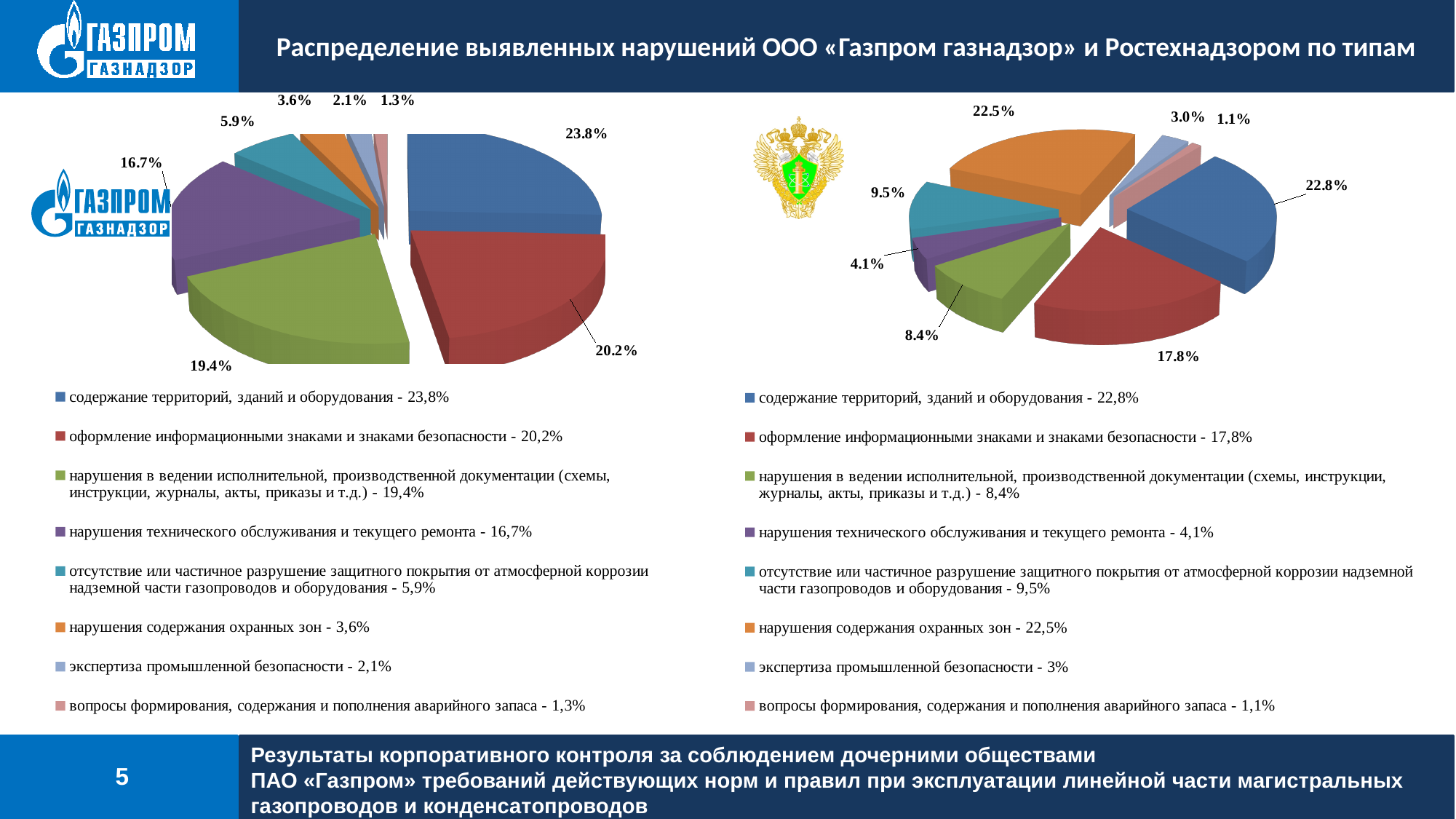
In the left pie chart (Газпром газнадзор), what is the difference between the shares for оформление информационными знаками и знаками безопасности and нарушения технического обслуживания и текущего ремонта? 3.5% In the left pie chart (Газпром газнадзор), what is the share for экспертиза промышленной безопасности? 2.1% How many categories does the left pie chart (Газпром газнадзор) contain? 8 In the right pie chart (Ростехнадзор), what is the share for нарушения содержания охранных зон? 22.5% In the right pie chart (Ростехнадзор), what is the difference between the shares for содержание территорий, зданий и оборудования and оформление информационными знаками и знаками безопасности? 5.0% In the right pie chart (Ростехнадзор), what is the share for нарушения технического обслуживания и текущего ремонта? 4.1% What colour represents нарушения в ведении исполнительной, производственной документации in both pie charts? green Which chart shows a larger share for нарушения содержания охранных зон, the left (Газпром газнадзор) or the right (Ростехнадзор)? right (Ростехнадзор) In the right pie chart (Ростехнадзор), which category has the smallest share? вопросы формирования, содержания и пополнения аварийного запаса In the left pie chart (Газпром газнадзор), which category has the largest share? содержание территорий, зданий и оборудования In the left pie chart (Газпром газнадзор), what is the share for содержание территорий, зданий и оборудования? 23.8% What type of chart is used on the left (Газпром газнадзор) side of the slide? pie chart